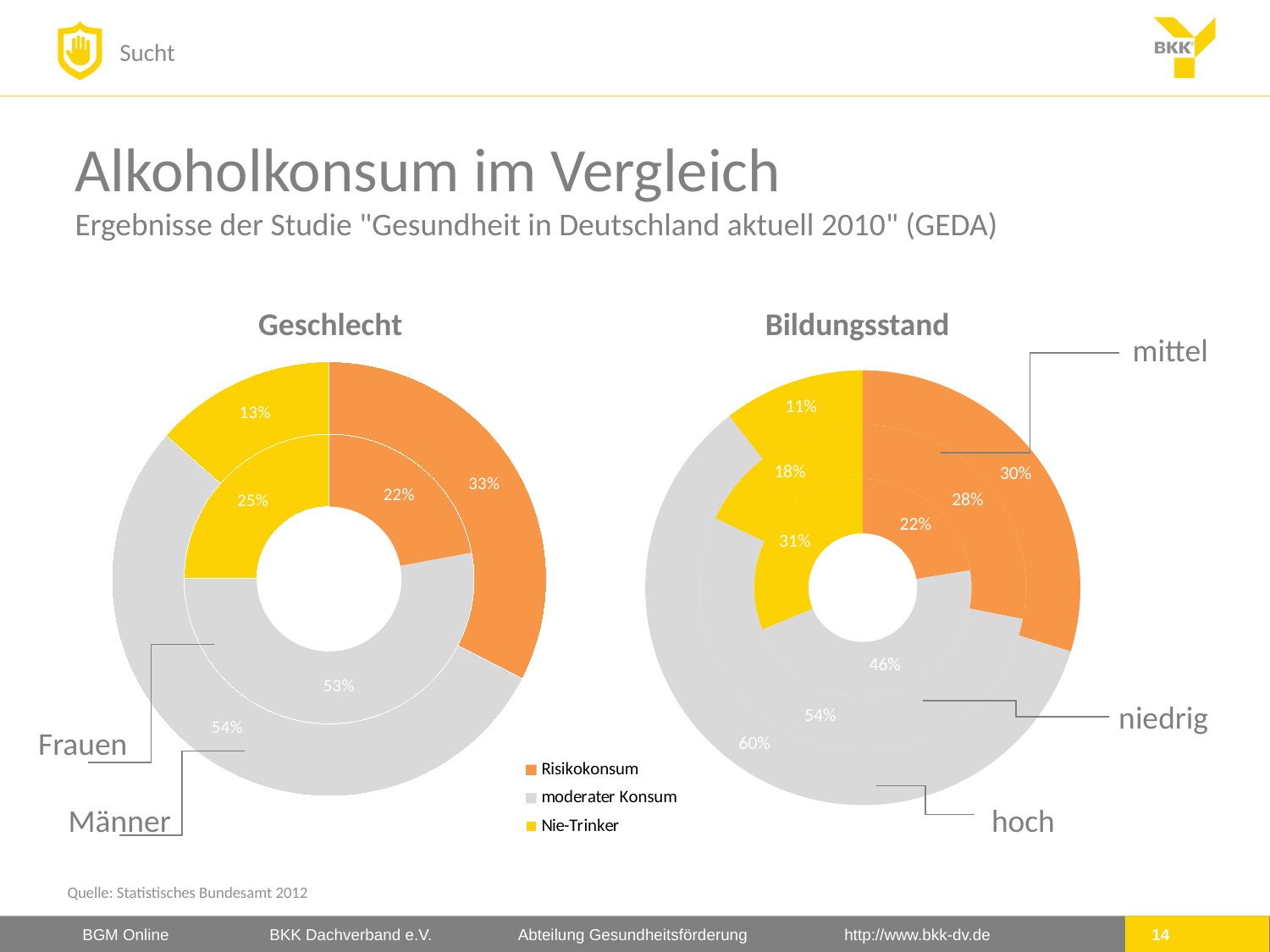
In the 'Geschlecht' chart, by how many percentage points is the Risikokonsum share for Männer higher than for Frauen? 11 percentage points In the 'Bildungsstand' chart, what is the largest Risikokonsum value shown? 30% What kind of chart is the 'Geschlecht' chart? doughnut chart In the 'Geschlecht' chart, what is the Risikokonsum share for Männer? 33% In the 'Geschlecht' chart, what is the moderater Konsum share for Männer? 54% In the 'Geschlecht' chart, which consumption category has the largest share for Männer? moderater Konsum In the 'Geschlecht' chart, is the Nie-Trinker share larger for Frauen or for Männer? Frauen How many education levels are labelled on the 'Bildungsstand' chart? 3 In the 'Bildungsstand' chart, what is the smallest Nie-Trinker value shown? 11% In the 'Geschlecht' chart, what is the Risikokonsum share for Frauen? 22% How many series does the legend list? 3 In the 'Geschlecht' chart, what is the Nie-Trinker share for Frauen? 25%